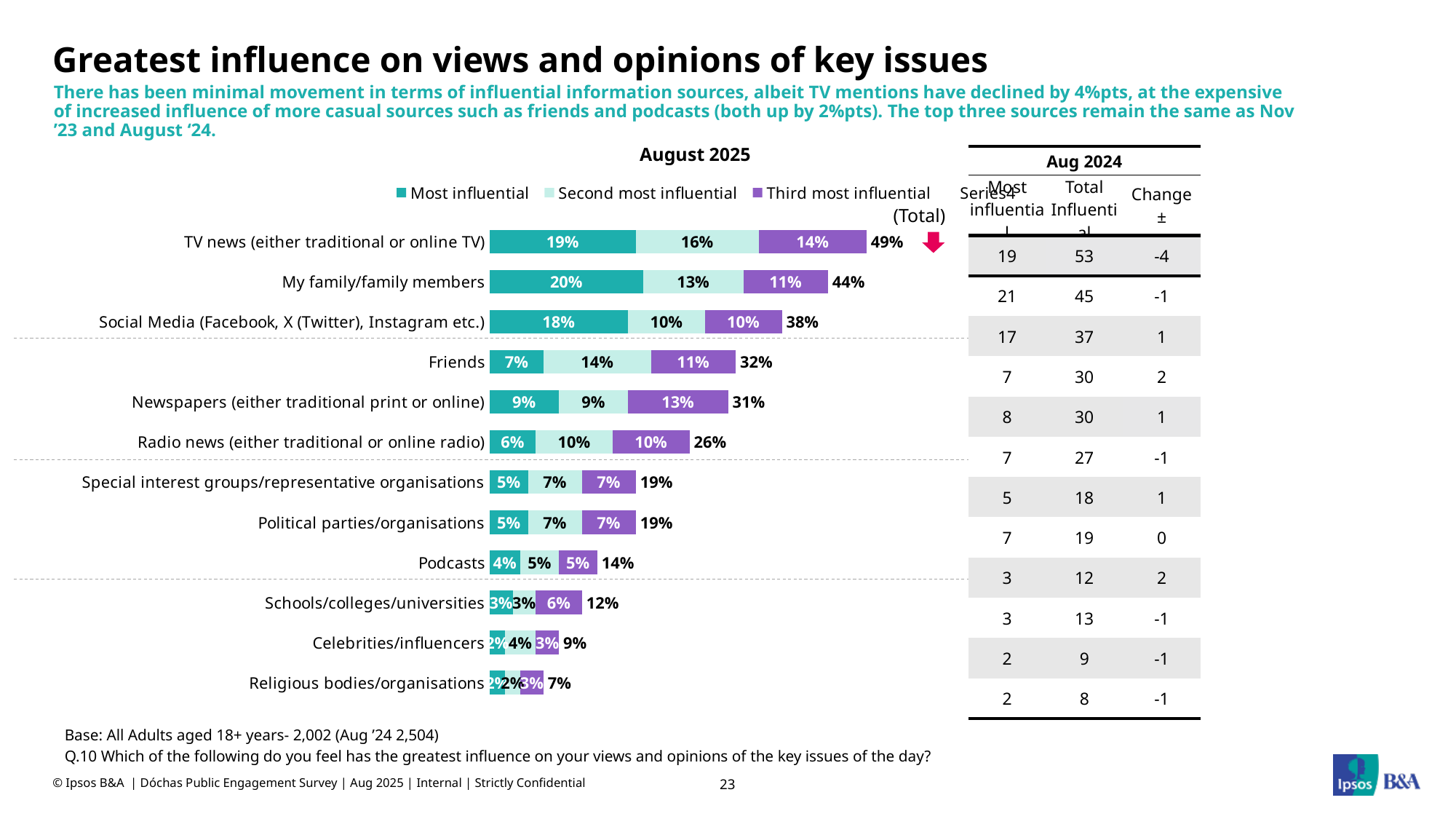
In the August 2025 chart, which source has the highest 'Most influential' value? My family/family members How many information sources (categories) are plotted in the August 2025 chart? 12 In the August 2025 chart, which source has the highest total percentage? TV news (either traditional or online TV) In the August 2025 chart, what is the 'Third most influential' value for Friends? 11% In the August 2025 chart, what is the difference between the total for TV news (49%) and the total for My family/family members (44%)? 5% In the August 2025 chart, what is the 'Second most influential' value for My family/family members? 13% In the August 2025 chart, what percentage of respondents named TV news (either traditional or online TV) as the most influential source? 19% In the August 2025 chart, what is the total percentage shown for Social Media (Facebook, X (Twitter), Instagram etc.)? 38% In the August 2025 chart, what is the total percentage shown for Radio news (either traditional or online radio)? 26% In the August 2025 chart, which source has the lowest total percentage? Religious bodies/organisations What type of chart is used to show the August 2025 data? Stacked bar chart In the August 2025 chart, which has a larger total: Podcasts or Schools/colleges/universities? Podcasts